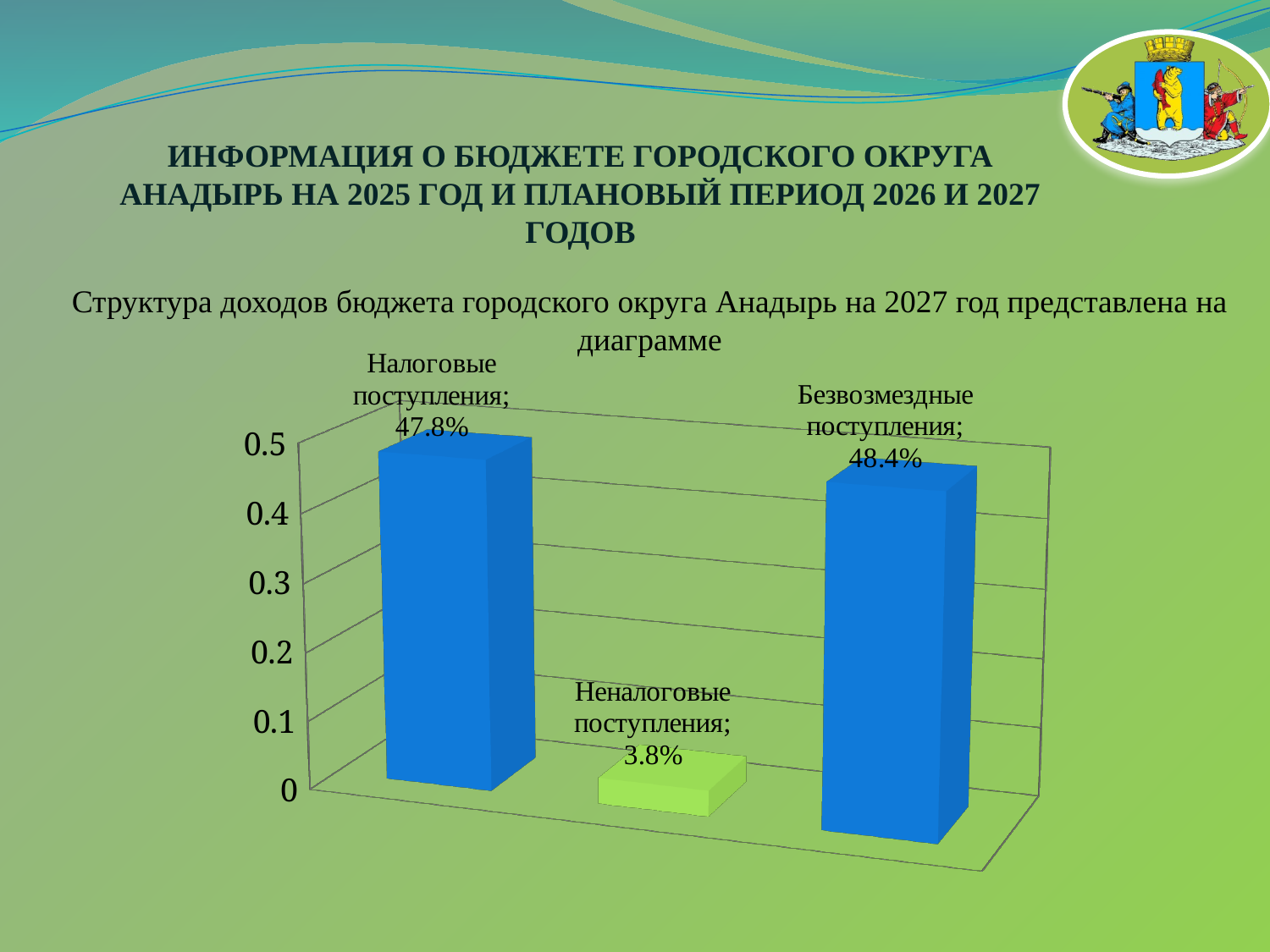
What is the difference between Налоговые поступления and Неналоговые поступления? 44% What is the value for Налоговые поступления? 47.8% Is the value for Неналоговые поступления greater or less than 0.1? less Which category has the lowest value? Неналоговые поступления What is the value for Безвозмездные поступления? 48.4% What kind of chart is shown on the slide? bar chart What is the difference between Безвозмездные поступления and Налоговые поступления? 0.6% Which is larger, Налоговые поступления or Неналоговые поступления? Налоговые поступления What colour is the bar for Неналоговые поступления? green Which category has the highest value? Безвозмездные поступления What is the value for Неналоговые поступления? 3.8% How many categories are shown in the chart? 3